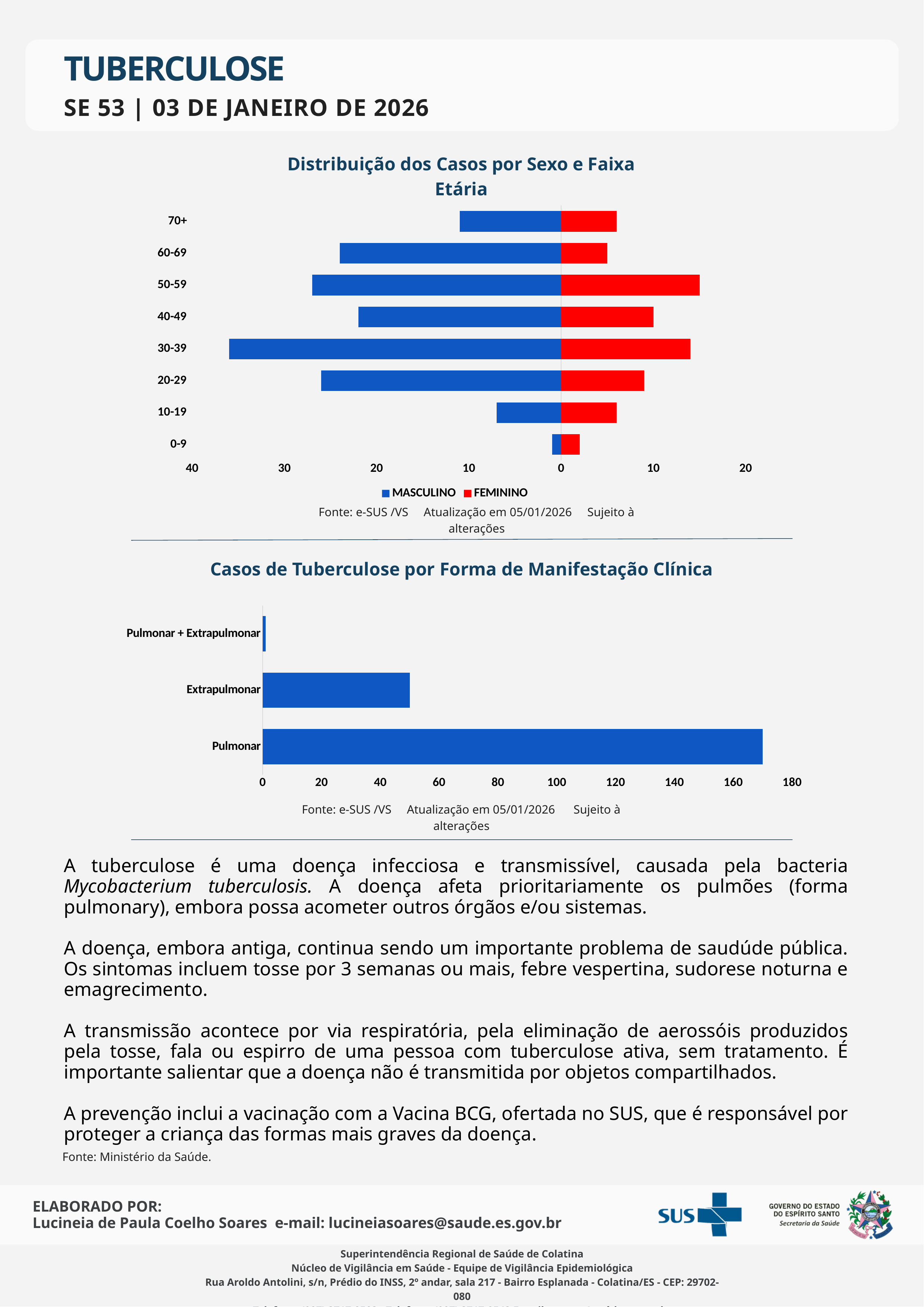
In the chart 'Casos de Tuberculose por Forma de Manifestação Clínica', which clinical form has the lowest number of cases? Pulmonar + Extrapulmonar In the chart 'Distribuição dos Casos por Sexo e Faixa Etária', is the FEMININO value for 60-69 greater or less than 10? less In the chart 'Distribuição dos Casos por Sexo e Faixa Etária', which age group has the highest number of MASCULINO cases? 30-39 How many series does the legend of the chart 'Distribuição dos Casos por Sexo e Faixa Etária' list? 2 In the chart 'Distribuição dos Casos por Sexo e Faixa Etária', which is larger for the 50-59 age group, MASCULINO or FEMININO? MASCULINO What kind of chart is 'Casos de Tuberculose por Forma de Manifestação Clínica'? Bar chart In the chart 'Distribuição dos Casos por Sexo e Faixa Etária', is the MASCULINO value for 30-39 greater or less than 30? greater How many age groups are shown in the chart 'Distribuição dos Casos por Sexo e Faixa Etária'? 8 In the chart 'Distribuição dos Casos por Sexo e Faixa Etária', which age group has the lowest number of MASCULINO cases? 0-9 What colour represents FEMININO in the chart 'Distribuição dos Casos por Sexo e Faixa Etária'? Red In the chart 'Casos de Tuberculose por Forma de Manifestação Clínica', which clinical form has the highest number of cases? Pulmonar In the chart 'Casos de Tuberculose por Forma de Manifestação Clínica', is the value for Pulmonar greater or less than 160? greater